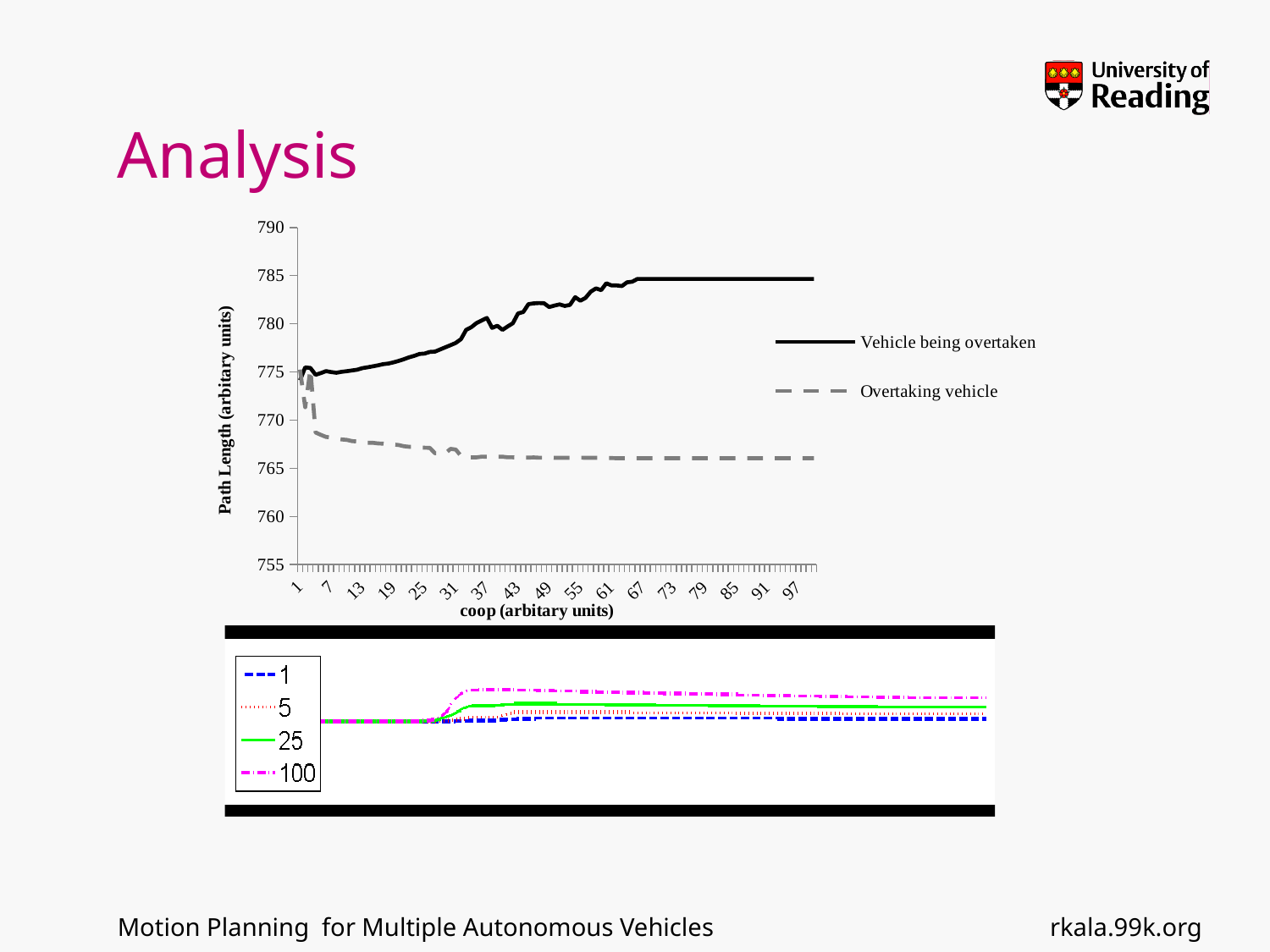
How many series does the legend of the top line chart list? 2 In the top line chart, is the value for Vehicle being overtaken at coop 97 greater or less than 780? greater In the top line chart, what are the two series named in the legend? Vehicle being overtaken; Overtaking vehicle In the top line chart, which series has the larger value at coop 97, Vehicle being overtaken or Overtaking vehicle? Vehicle being overtaken In the top line chart, is the value for Vehicle being overtaken at coop 55 greater or less than 780? greater In the top line chart, does the value for Vehicle being overtaken rise or fall as coop increases? rise In the top line chart, is the value for Overtaking vehicle at coop 97 greater or less than 770? less In the top line chart, which series reaches the highest path length? Vehicle being overtaken In the top line chart, does the value for Overtaking vehicle rise or fall as coop increases? fall What kind of chart is the top chart on the slide? line chart In the top line chart, what is the title of the vertical axis? Path Length (arbitary units)